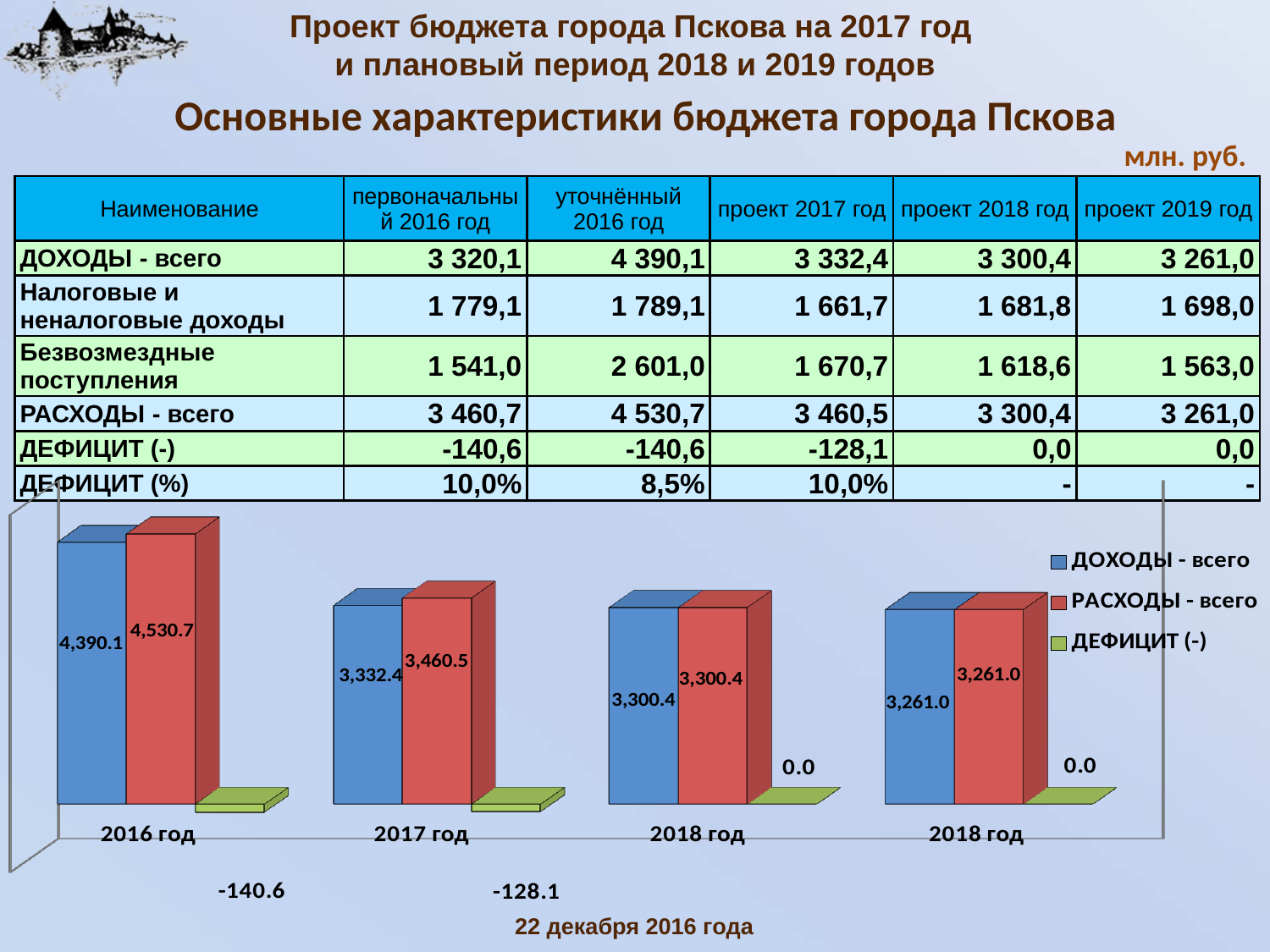
What kind of chart is shown at the bottom of the slide? bar chart In the chart, what is the value of РАСХОДЫ - всего for 2017 год? 3,460.5 In the chart, which is larger for 2016 год: ДОХОДЫ - всего or РАСХОДЫ - всего? РАСХОДЫ - всего How many category groups are plotted along the x axis of the chart? 4 In the chart, what is the value of ДЕФИЦИТ (-) for 2017 год? -128.1 In the chart, what is the difference between РАСХОДЫ - всего and ДОХОДЫ - всего for 2017 год? 128.1 How many series does the chart legend list? 3 Which category group has the highest ДОХОДЫ - всего bar in the chart? 2016 год In the chart, what is the value of ДОХОДЫ - всего for 2016 год? 4,390.1 In the chart, what is the value of ДОХОДЫ - всего for the rightmost group? 3,261.0 In the chart, what is the value of РАСХОДЫ - всего for 2016 год? 4,530.7 Do the ДОХОДЫ - всего values in the chart rise or fall from left to right along the x axis? fall